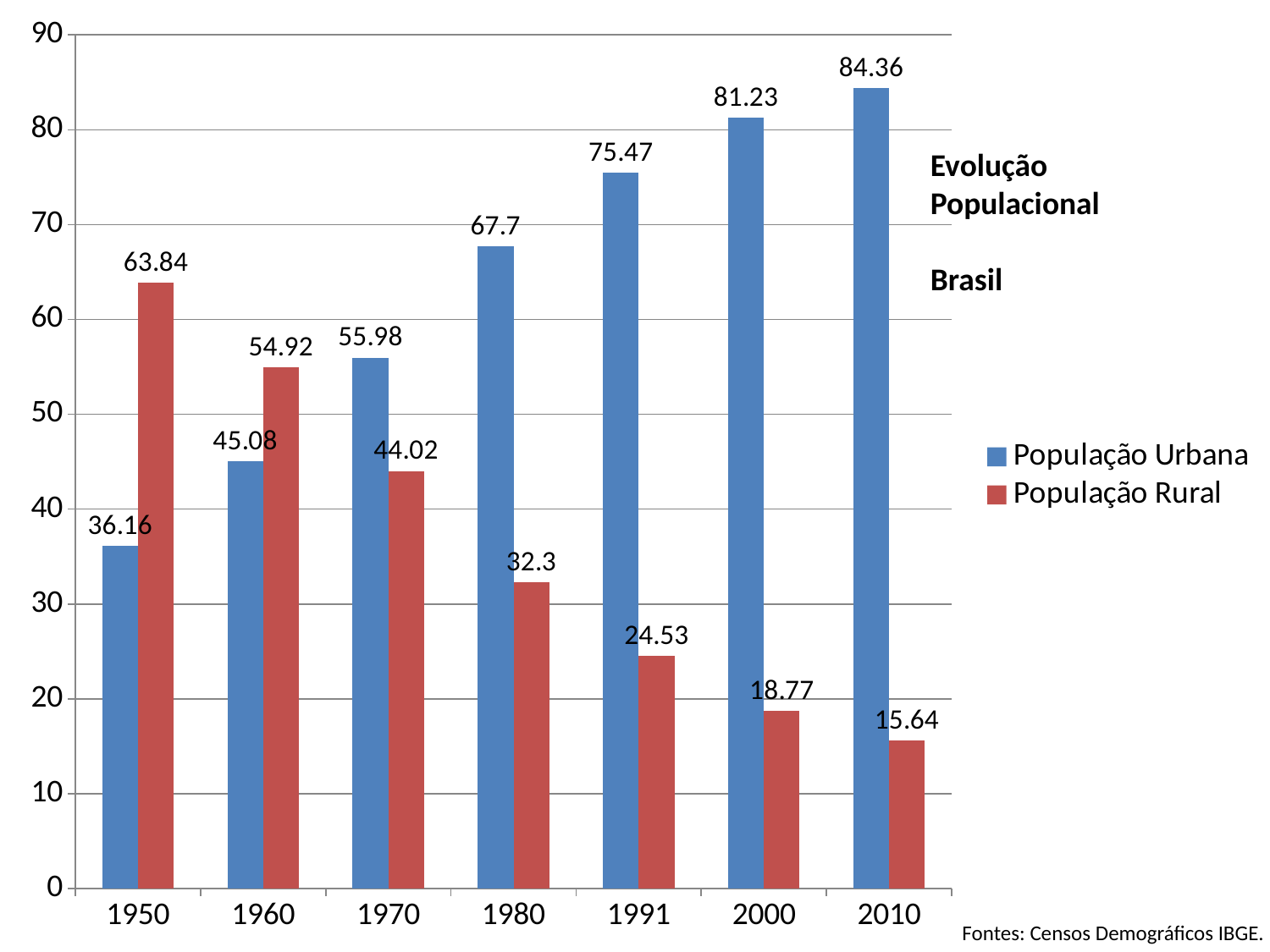
What kind of chart is shown? bar chart Is the value for População Urbana in 1991 greater or less than 70? greater What is the value for População Rural in 2010? 15.64 What is the difference between População Urbana and População Rural in 2000? 62.46 Does População Rural rise or fall from 1950 to 2010? fall What is the value for População Rural in 1980? 32.3 In which year is População Urbana highest? 2010 What is the value for População Urbana in 1950? 36.16 In which year is População Rural lowest? 2010 How many years are shown on the x axis? 7 Which is larger in 1960, População Urbana or População Rural? População Rural How many series does the legend list? 2